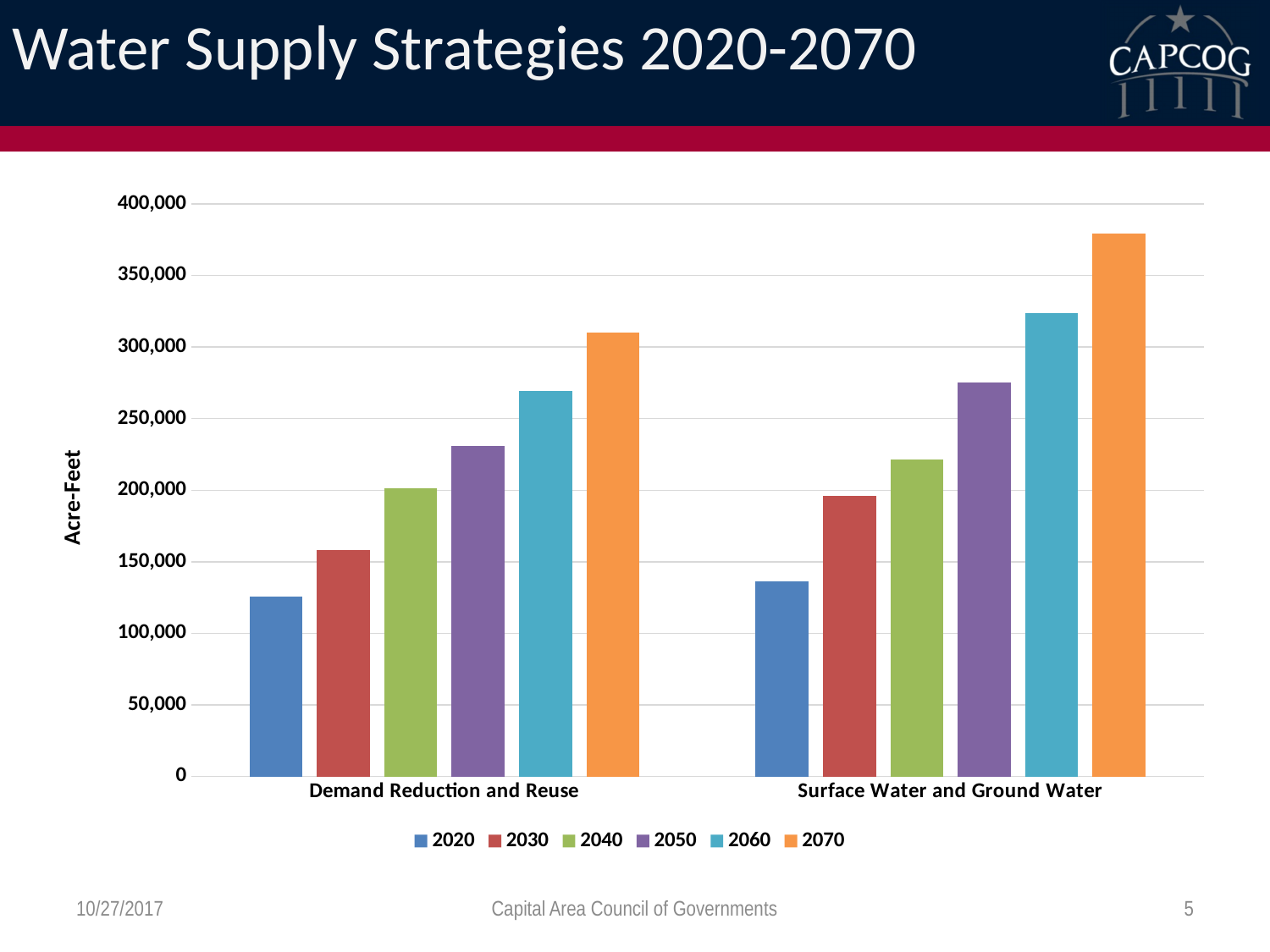
What kind of chart is shown on the slide? bar chart Is the 2020 value for Demand Reduction and Reuse greater or less than 150,000? less Which is larger for 2070: Demand Reduction and Reuse or Surface Water and Ground Water? Surface Water and Ground Water Which year has the highest value for Surface Water and Ground Water? 2070 How many series does the legend list? 6 Is the 2050 value for Surface Water and Ground Water greater or less than 250,000? greater Do the values for Surface Water and Ground Water rise or fall from 2020 to 2070? rise Is the 2070 value for Surface Water and Ground Water greater or less than 350,000? greater What is the label on the vertical axis? Acre-Feet Which year has the lowest value for Demand Reduction and Reuse? 2020 How many categories are shown on the x axis? 2